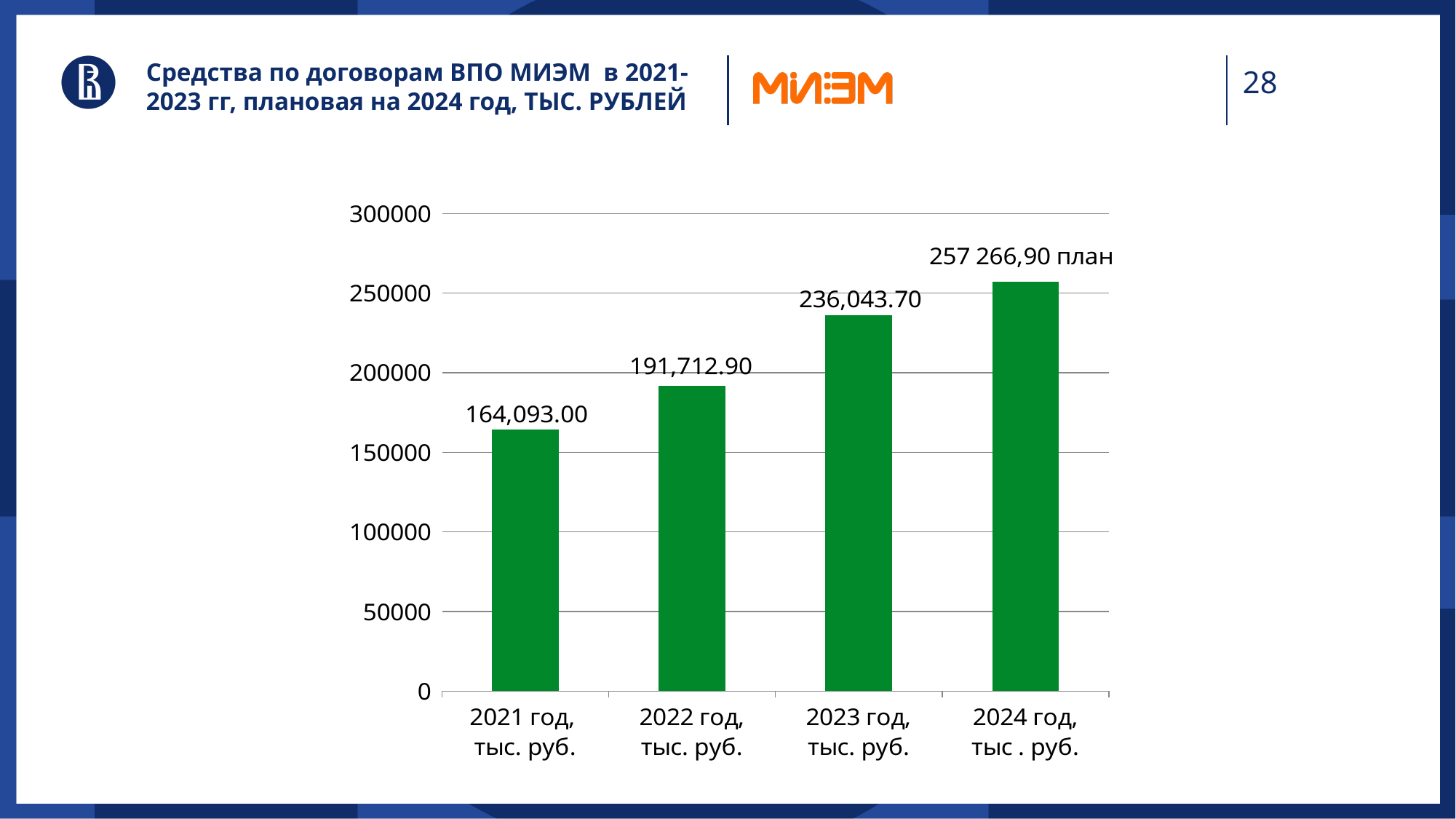
Which is larger, the value for 2023 or the value for 2022? 2023 How many bars are plotted on the chart? 4 What is the value shown for 2022 год, тыс. руб.? 191,712.90 What kind of chart is shown on the slide? Bar chart What is the difference between the values for 2023 and 2022? 44,330.80 Which year has the highest value on the chart? 2024 год, тыс. руб. What is the difference between the values for 2022 and 2021? 27,619.90 Which year has the lowest value on the chart? 2021 год, тыс. руб. What is the value shown for 2021 год, тыс. руб.? 164,093.00 What is the planned value shown for 2024 год, тыс. руб.? 257 266,90 Do the values rise or fall from 2021 to 2024? Rise What is the value shown for 2023 год, тыс. руб.? 236,043.70